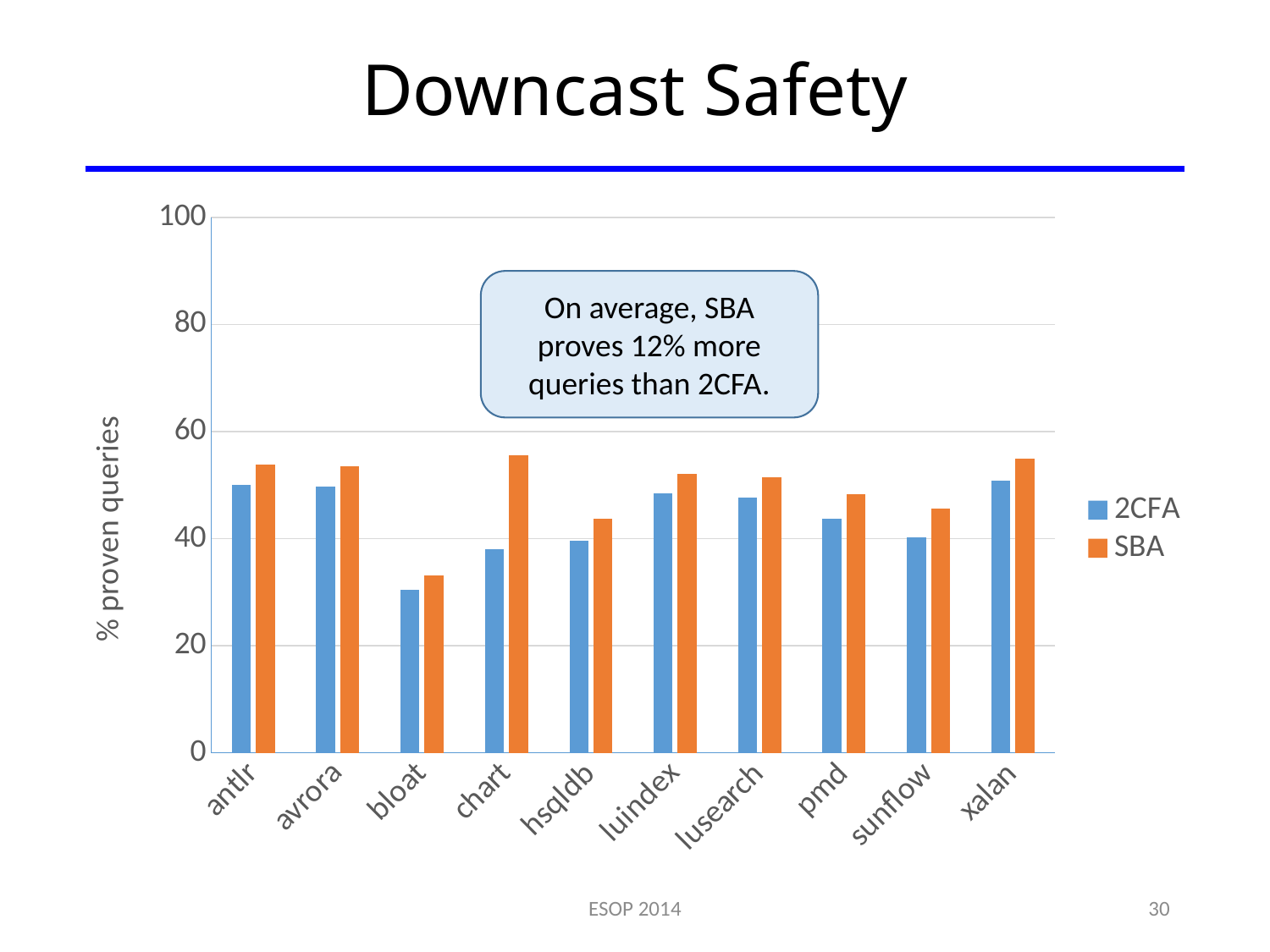
How many benchmark categories are shown on the x axis? 10 What is the label of the y axis? % proven queries Is the 2CFA value for antlr greater or less than 60? less Is the 2CFA value for bloat greater or less than 40? less For chart, which series has the larger value, 2CFA or SBA? SBA Is the SBA value for chart greater or less than 40? greater Which category has the lowest SBA value? bloat What kind of chart is shown on the slide? bar chart Which category has the lowest 2CFA value? bloat How many series does the legend list? 2 Which is larger, the 2CFA value for bloat or the 2CFA value for xalan? xalan